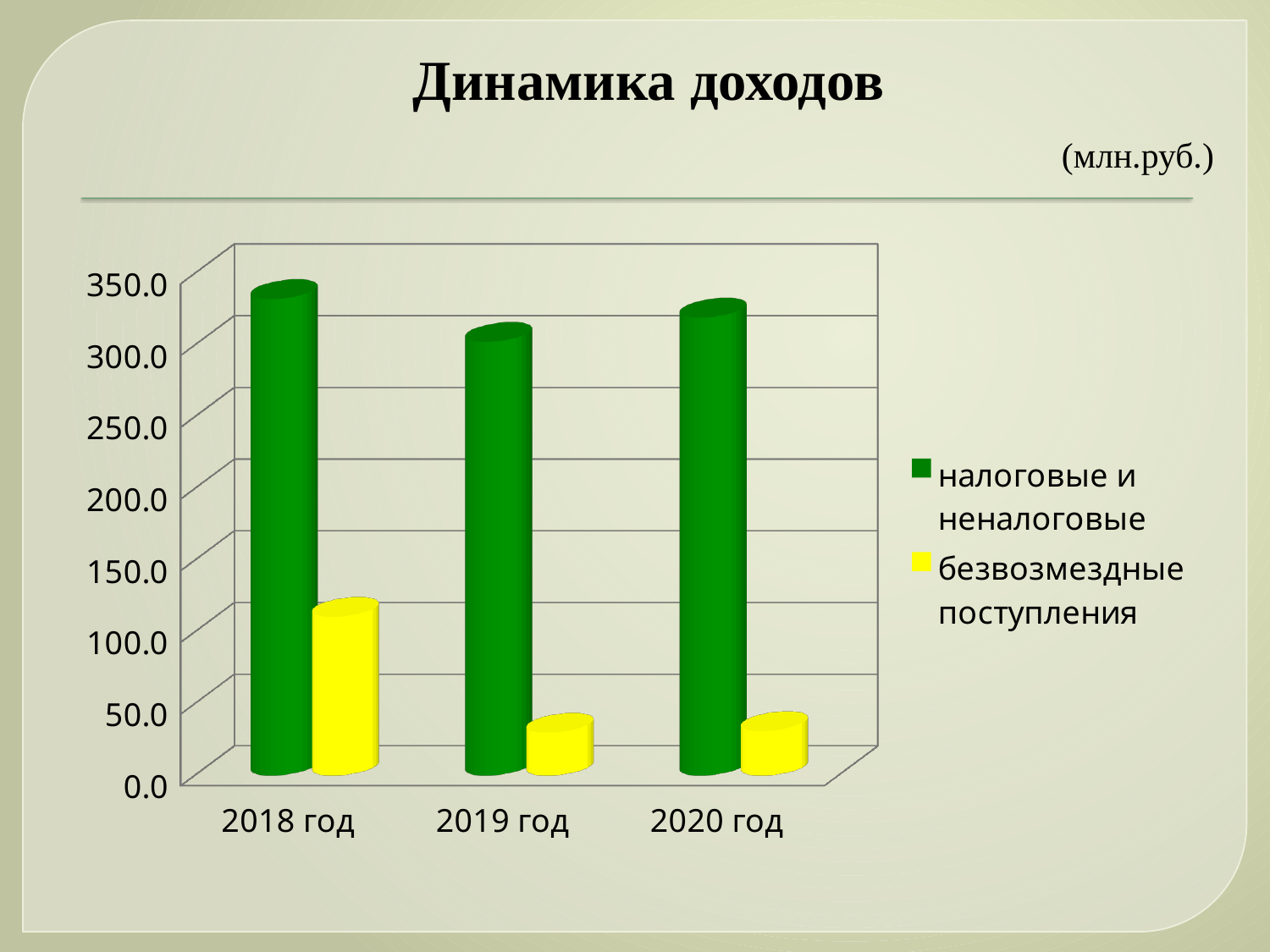
What kind of chart is shown on the slide? bar chart How many series does the legend list? 2 What is the title of the chart on the slide? Динамика доходов Is the value for 'налоговые и неналоговые' in 2018 год greater or less than 300.0? greater Which is larger in 2018 год: 'налоговые и неналоговые' or 'безвозмездные поступления'? налоговые и неналоговые In which year is the value for 'налоговые и неналоговые' the lowest? 2019 год Which colour represents the series 'безвозмездные поступления'? yellow Is the value for 'безвозмездные поступления' in 2019 год greater or less than 50.0? less In which year is the value for 'налоговые и неналоговые' the highest? 2018 год In which year is the value for 'безвозмездные поступления' the highest? 2018 год How many years (categories) are shown on the x axis? 3 Does the value for 'безвозмездные поступления' rise or fall from 2018 год to 2019 год? fall